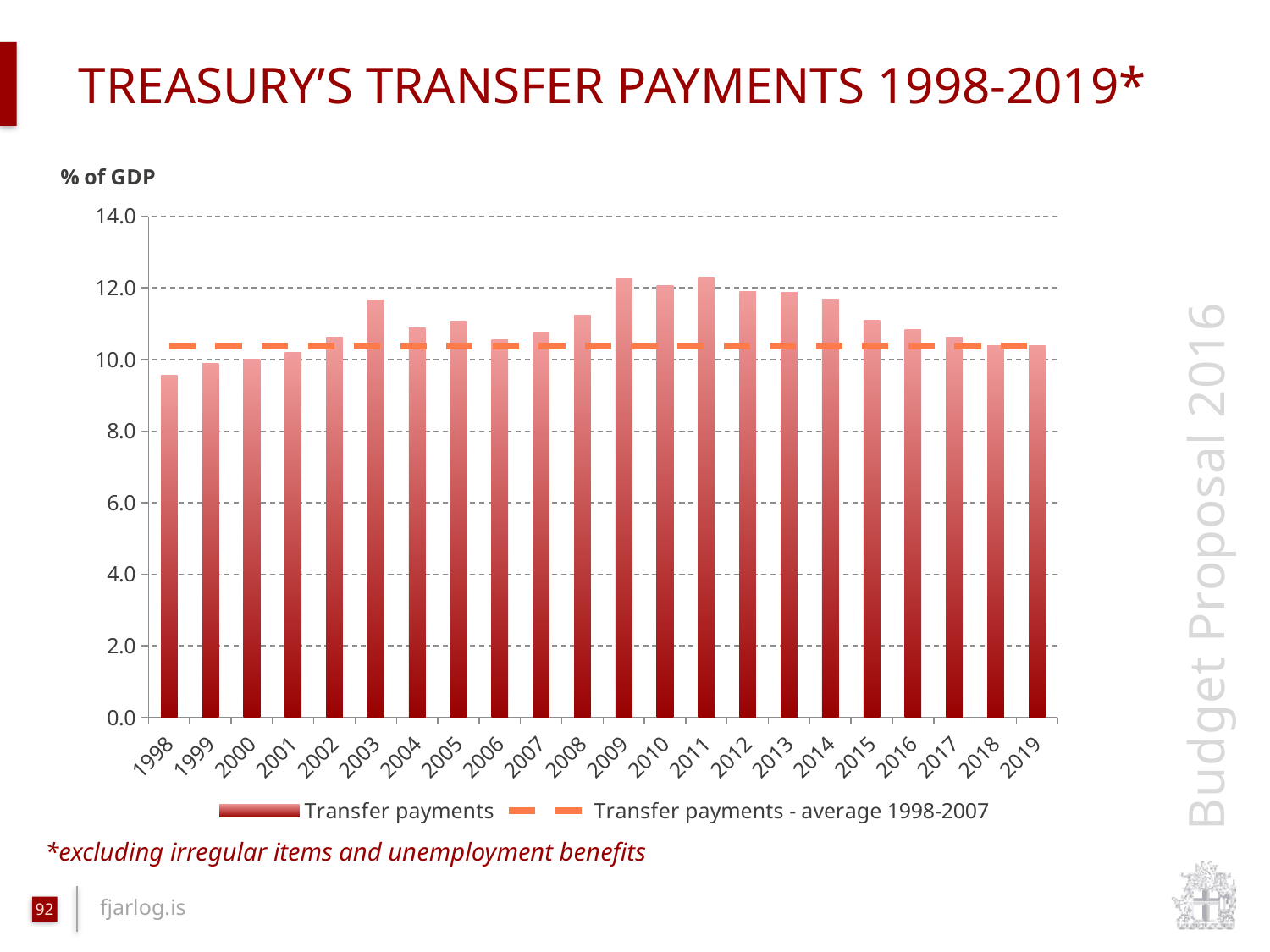
Is the value for 2015 greater or less than 10.0? greater Is the value for 2003 greater or less than 12.0? less Which is larger, the transfer payments for 2009 or for 1998? 2009 What kind of chart is shown on the slide? Combination bar and line chart How many series does the legend list? 2 What does the dashed orange line in the legend represent? Transfer payments - average 1998-2007 Is the value for 1998 greater or less than 10.0? less Which year has the lowest transfer payments as % of GDP? 1998 Do the transfer payments rise or fall from 2011 to 2019? fall Which is larger, the transfer payments for 2003 or for 2004? 2003 How many years (bars) are plotted on the chart? 22